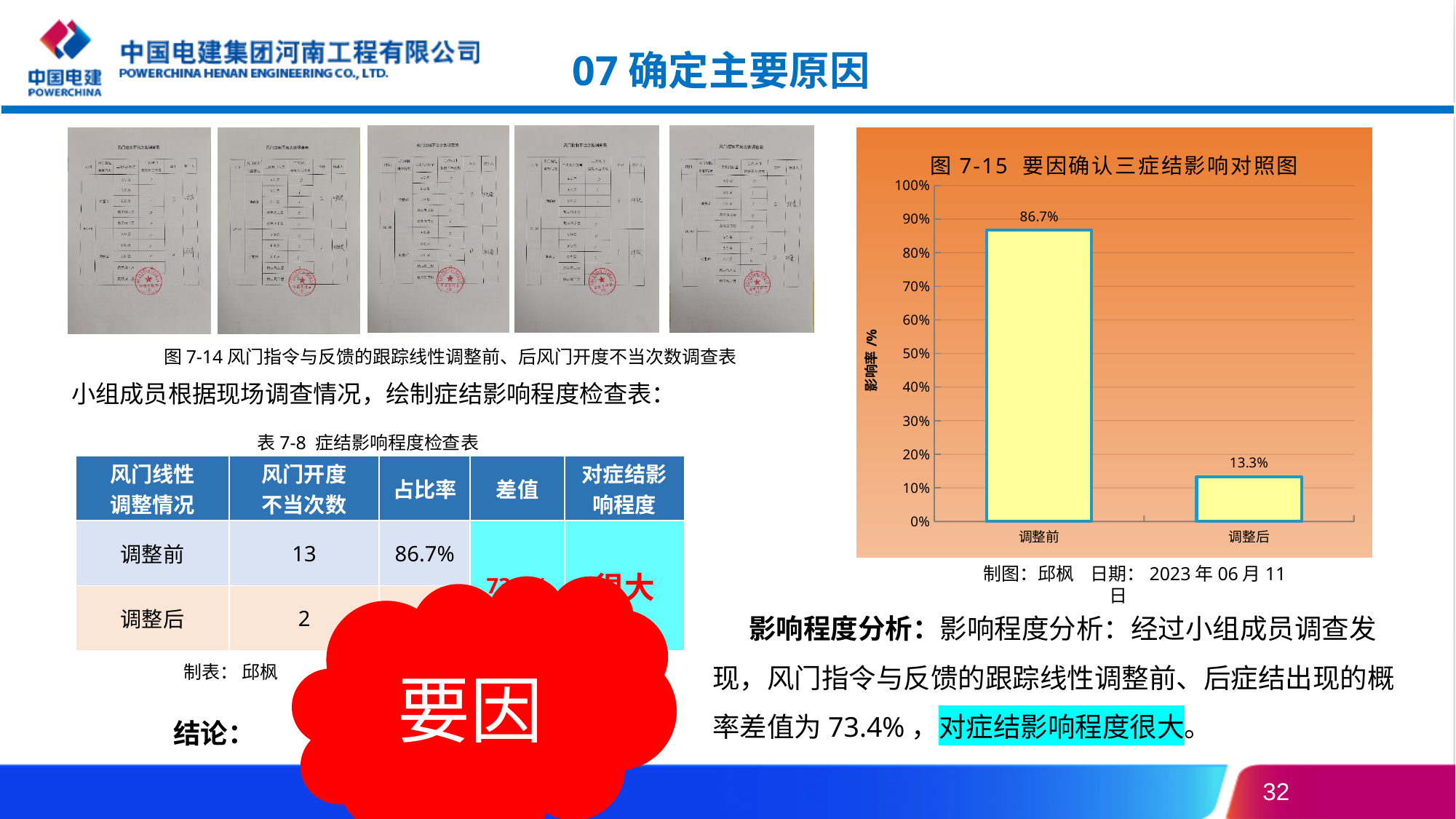
What is the value for 调整前 in the chart? 86.7% What kind of chart is shown on the slide? bar chart Is the value for 调整前 greater or less than 80%? greater Is the value for 调整后 greater or less than 20%? less What is the difference between the values for 调整前 and 调整后? 73.4% Which category has the lowest value in the chart? 调整后 Do the values rise or fall from 调整前 to 调整后? fall Which is larger, the value for 调整前 or the value for 调整后? 调整前 What is the title of the chart? 图 7-15 要因确认三症结影响对照图 How many categories are shown on the x axis of the chart? 2 What is the value for 调整后 in the chart? 13.3% Which category has the highest value in the chart? 调整前